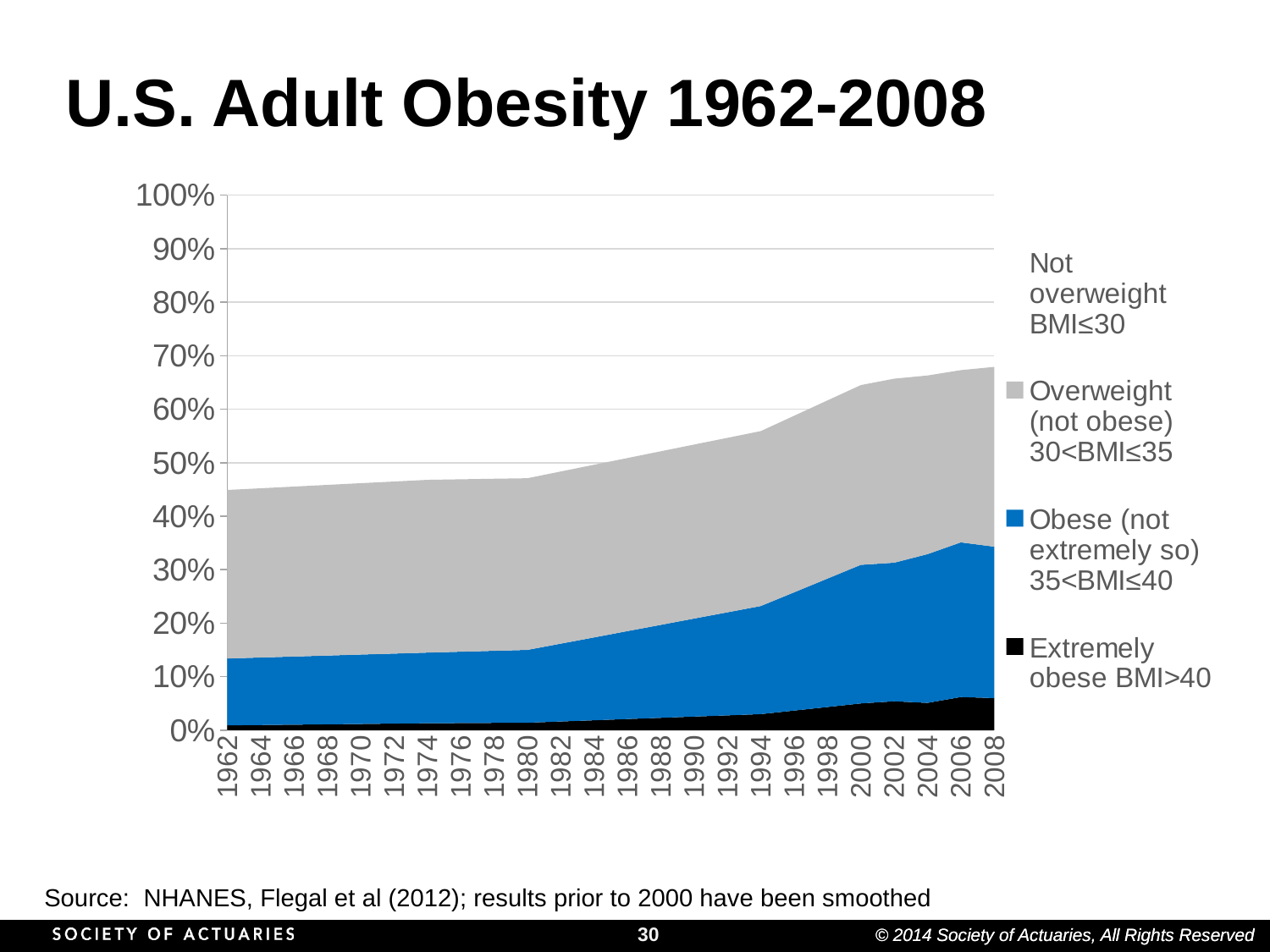
What is the title of the chart? U.S. Adult Obesity 1962-2008 How many years are labeled along the x axis? 24 How many series does the legend list? 4 Is the combined share of obese and extremely obese adults in 1962 greater or less than 20%? less Is the combined share of obese and extremely obese adults in 2008 greater or less than 30%? greater Is the combined share of overweight, obese and extremely obese adults in 1962 greater or less than 50%? less What kind of chart is shown on the slide? Stacked area chart Does the share of adults who are obese (not extremely so) rise or fall from 1962 to 2008? Rise Which is larger in 2008: the combined share of obese and extremely obese adults, or the share of extremely obese adults alone? Combined obese and extremely obese Which colour represents the 'Obese (not extremely so) 35<BMI≤40' series? Blue